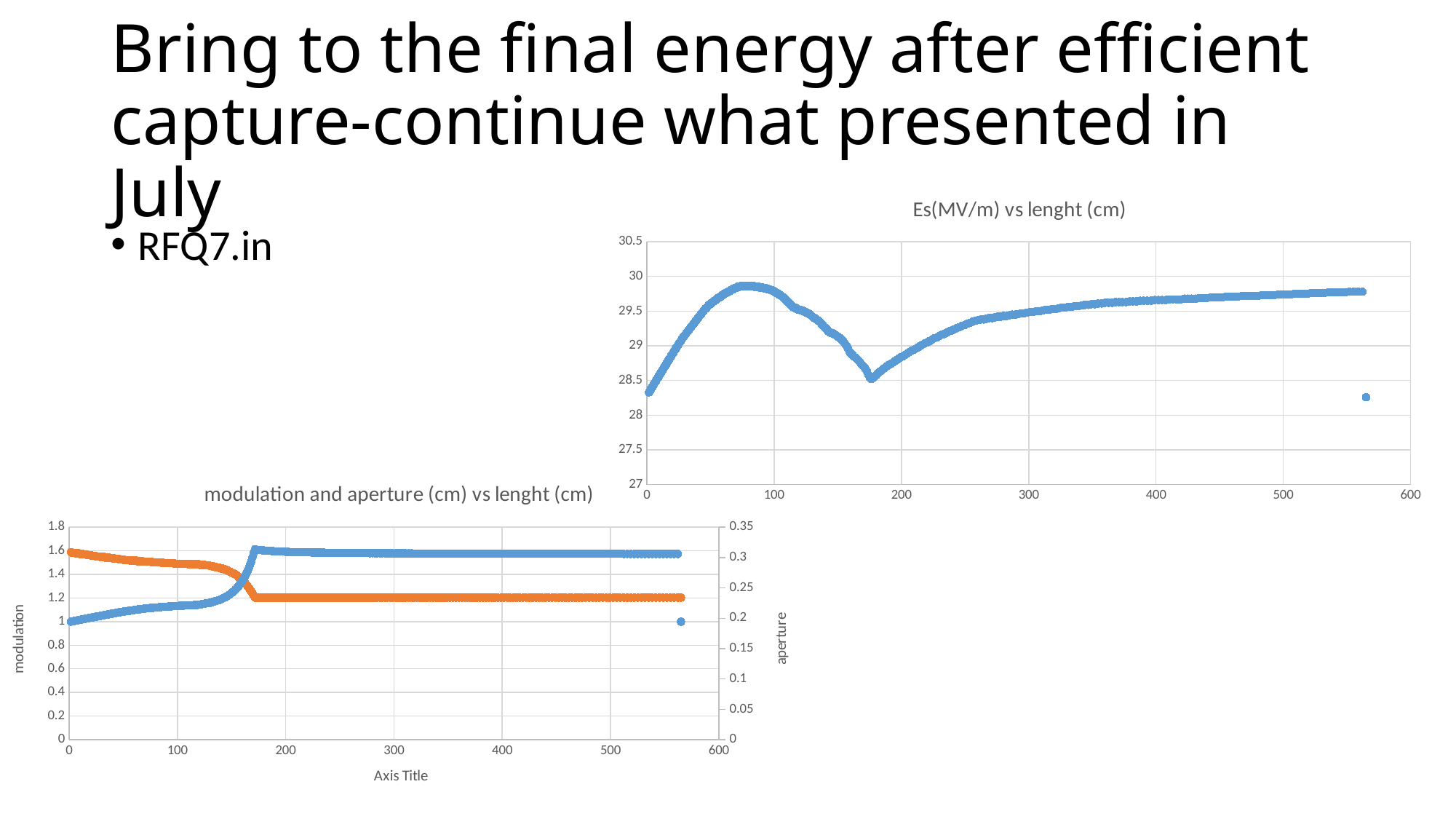
In the chart "Es(MV/m) vs lenght (cm)", is the value at length 0 greater or less than 28.5? less In the chart "modulation and aperture (cm) vs lenght (cm)", is the modulation value at length 300 greater or less than 1.4? greater In the chart "modulation and aperture (cm) vs lenght (cm)", what is the label on the right-hand vertical axis? aperture In the chart "Es(MV/m) vs lenght (cm)", is the value at length 500 greater or less than 29.5? greater In the chart "Es(MV/m) vs lenght (cm)", does the value rise or fall between length 100 and length 180? fall In the chart "modulation and aperture (cm) vs lenght (cm)", does the orange aperture series rise or fall between length 0 and length 170? fall In the chart "modulation and aperture (cm) vs lenght (cm)", what is the label shown on the horizontal axis? Axis Title What kind of chart is the chart titled "modulation and aperture (cm) vs lenght (cm)"? scatter chart What kind of chart is the chart titled "Es(MV/m) vs lenght (cm)"? scatter chart